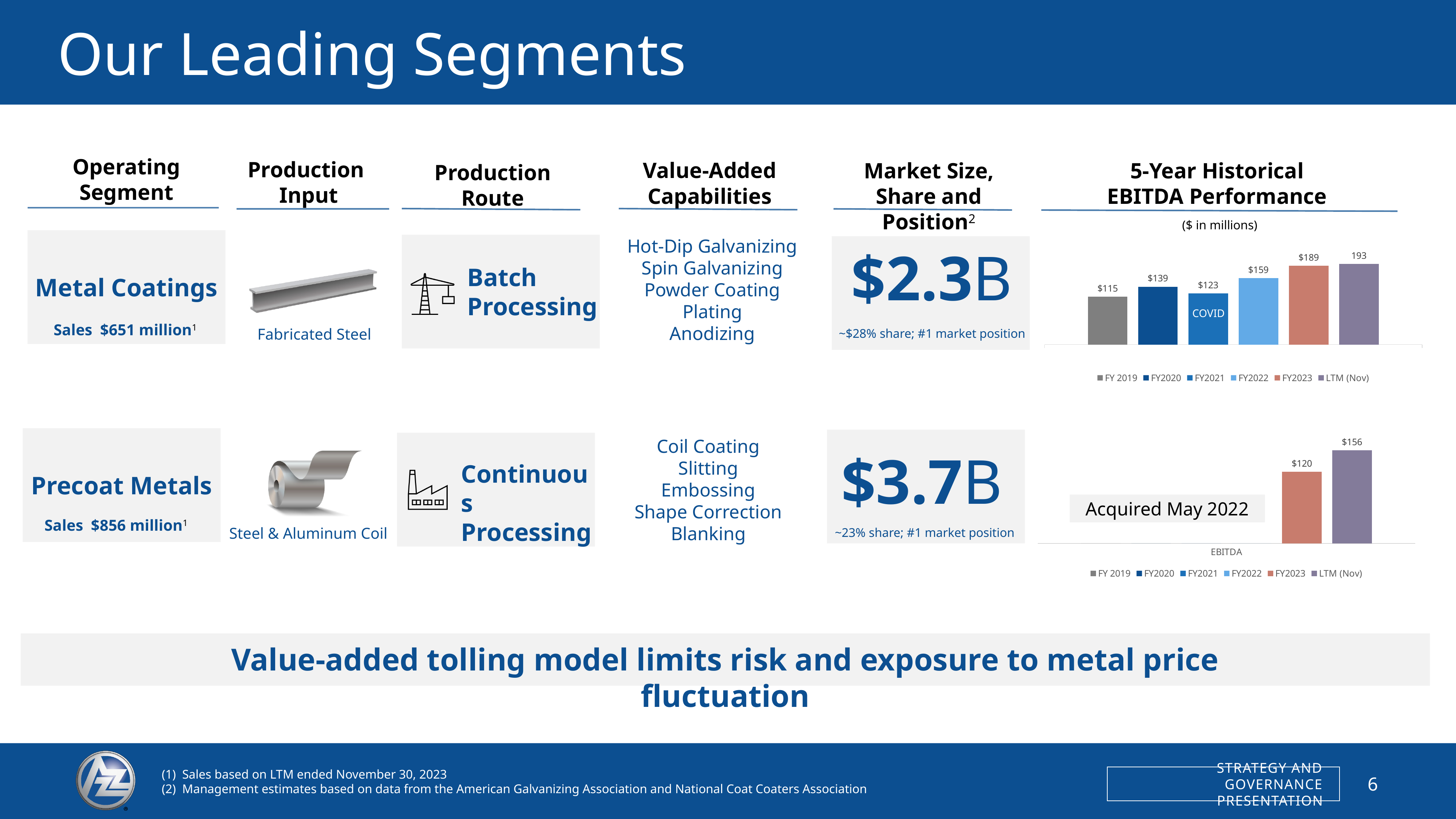
In the Precoat Metals EBITDA chart (bottom), what is the EBITDA value for LTM (Nov)? $156 In the Metal Coatings EBITDA chart (top), what is the EBITDA value for FY2023? $189 In the Metal Coatings EBITDA chart (top), which period has the highest EBITDA? LTM (Nov) In the Precoat Metals EBITDA chart (bottom), what is the EBITDA value for FY2023? $120 In the Metal Coatings EBITDA chart (top), what is the EBITDA value for FY2020? $139 In the Metal Coatings EBITDA chart (top), what is the difference between the FY2023 and FY2022 EBITDA values? $30 In the Metal Coatings EBITDA chart (top), how many bars are plotted? 6 What kind of chart is used to show the 5-Year Historical EBITDA Performance for Metal Coatings? Bar chart In the Metal Coatings EBITDA chart (top), which period has the lowest EBITDA? FY 2019 In the Precoat Metals EBITDA chart (bottom), what is the difference between the LTM (Nov) and FY2023 values? $36 In the Metal Coatings EBITDA chart (top), what is the EBITDA value for FY 2019? $115 In the Metal Coatings EBITDA chart (top), which is larger, the FY2020 value or the FY2021 value? FY2020